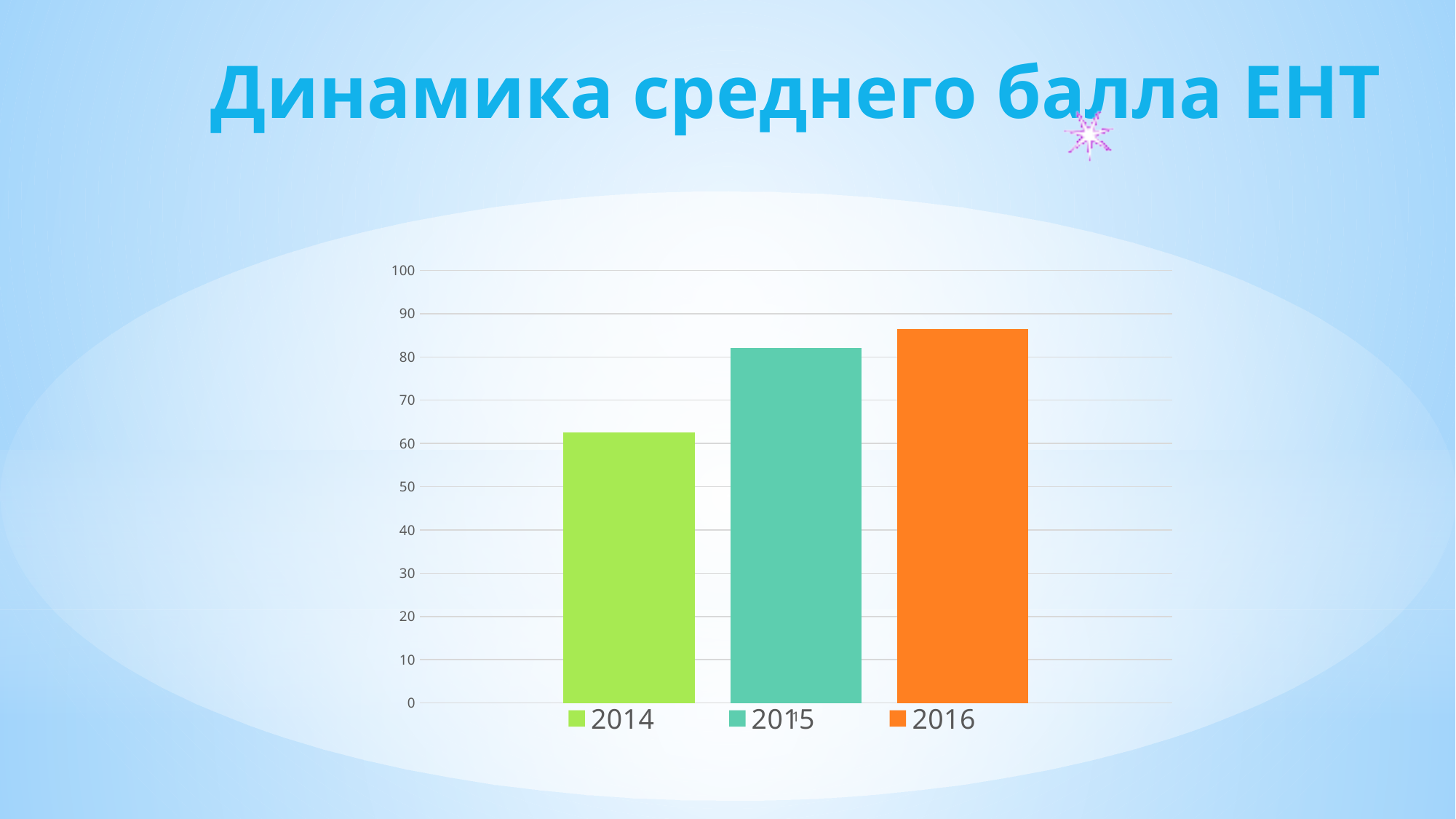
Which year has the lowest bar? 2014 Which year has the highest bar? 2016 Is the value for 2016 greater or less than 90? less Which is larger, the value for 2016 or the value for 2015? 2016 What colour is the bar for 2016? orange Do the values rise or fall from 2014 to 2016? rise Is the value for 2014 greater or less than 70? less What kind of chart is shown on the slide? bar chart Is the value for 2014 greater or less than 60? greater How many series does the legend list? 3 What is the title of the slide? Динамика среднего балла ЕНТ Which is larger, the value for 2015 or the value for 2014? 2015